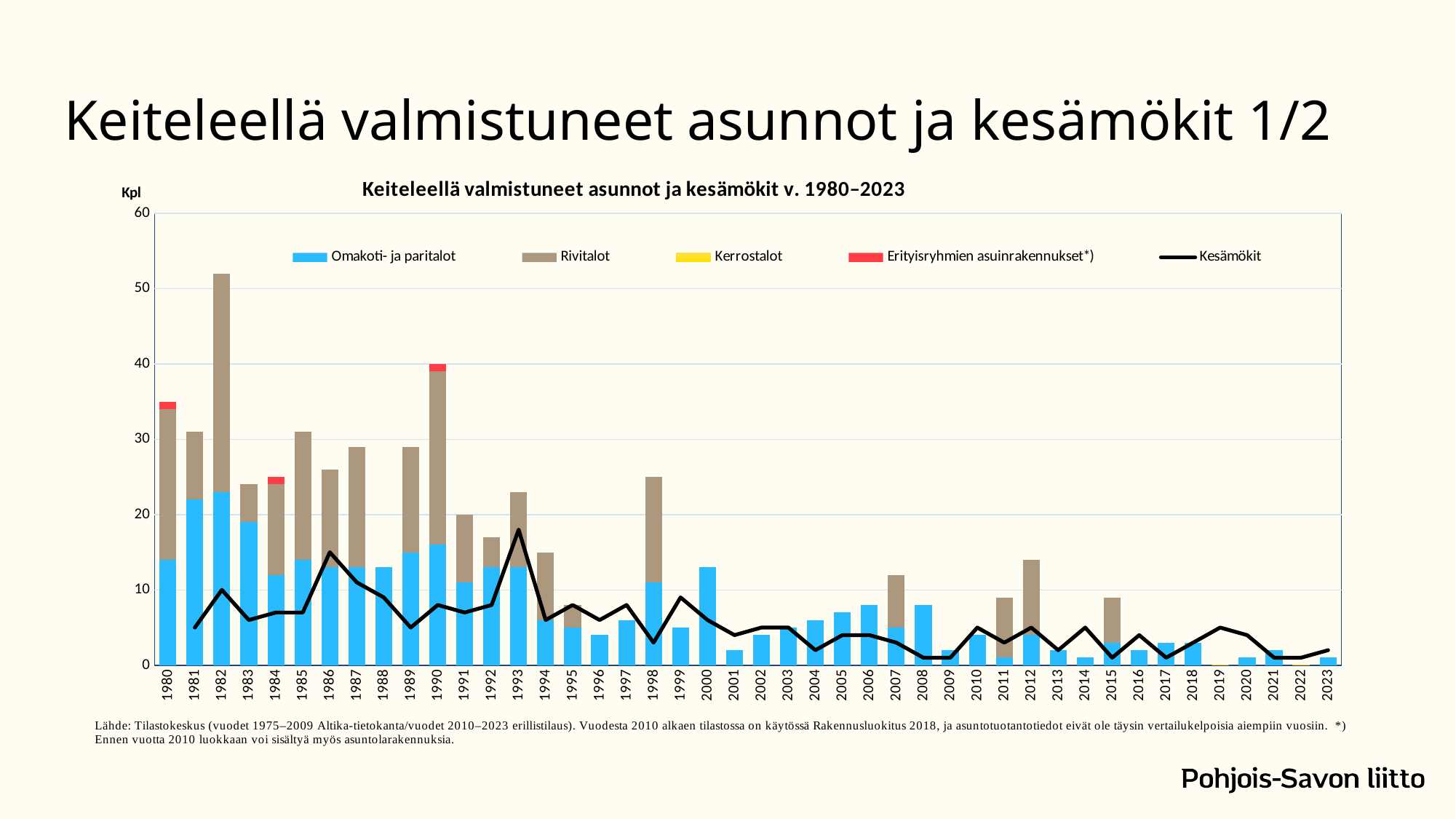
Do the total stacked bars generally rise or fall from the 1980s to the 2020s? fall Which year has the larger total stacked bar, 1981 or 1982? 1982 How many series does the chart legend list? 5 Which year has the highest total stacked bar? 1982 Is the total stacked bar for 1980 greater or less than 30? greater Which year has the larger total stacked bar, 1998 or 1999? 1998 What kind of chart is this? Bar chart with a line series How many years are shown on the x axis of the chart? 44 Is the total stacked bar for 1982 greater or less than 40? greater Is the Kesämökit line value for 1993 greater or less than 15? greater What is the title of the chart? Keiteleellä valmistuneet asunnot ja kesämökit v. 1980–2023